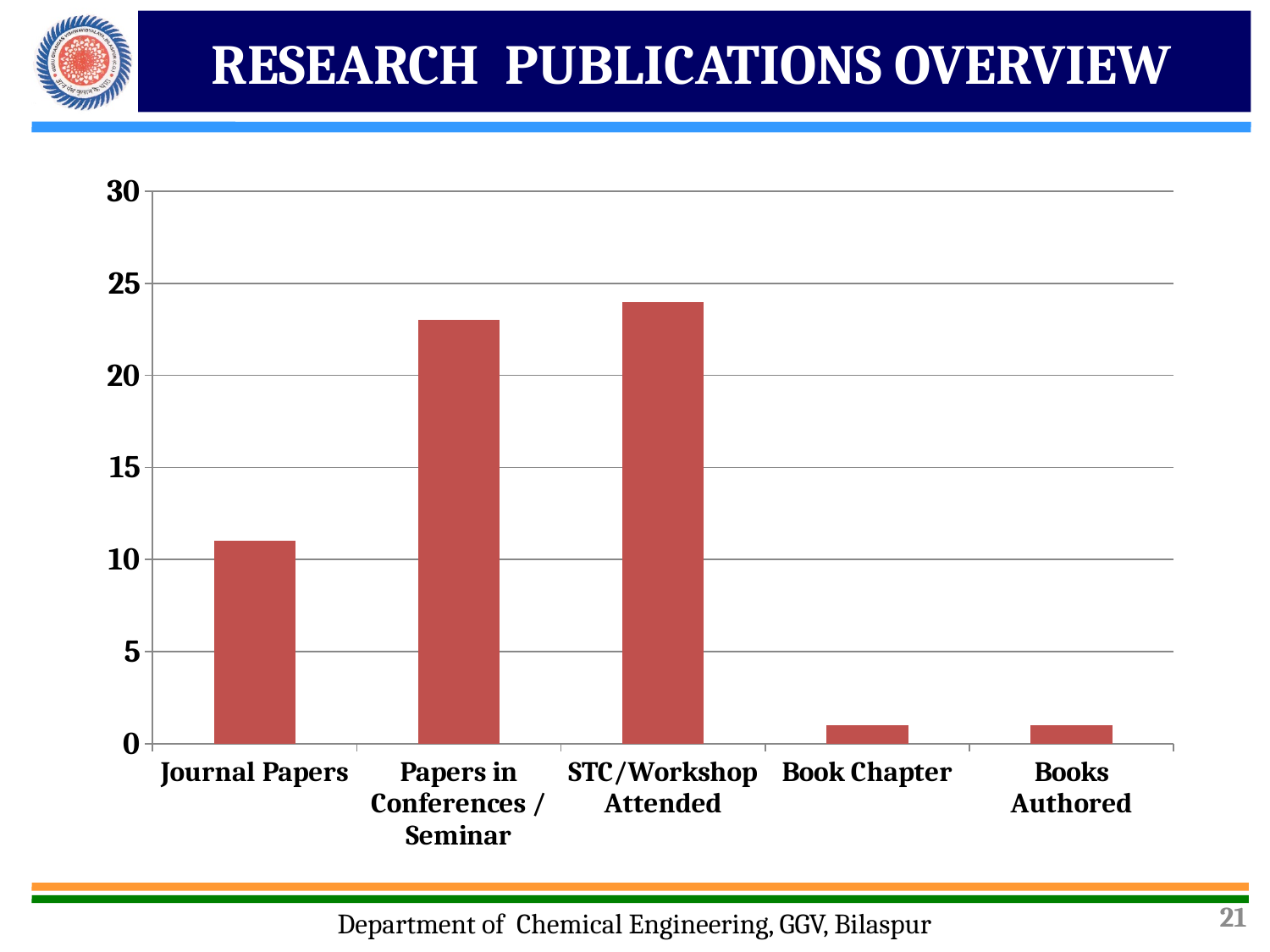
Which is larger, the value for Journal Papers or the value for Papers in Conferences / Seminar? Papers in Conferences / Seminar Is the value for Book Chapter greater or less than 5? less Is the value for Books Authored greater or less than 5? less What kind of chart is shown on the slide? Bar chart Is the value for STC/Workshop Attended greater or less than 20? greater What is the title of the slide containing the chart? RESEARCH PUBLICATIONS OVERVIEW How many categories are shown on the x axis of the chart? 5 Which is larger, the value for Journal Papers or the value for Book Chapter? Journal Papers What is the highest value shown on the chart's vertical axis? 30 Which category has the tallest bar in the chart? STC/Workshop Attended